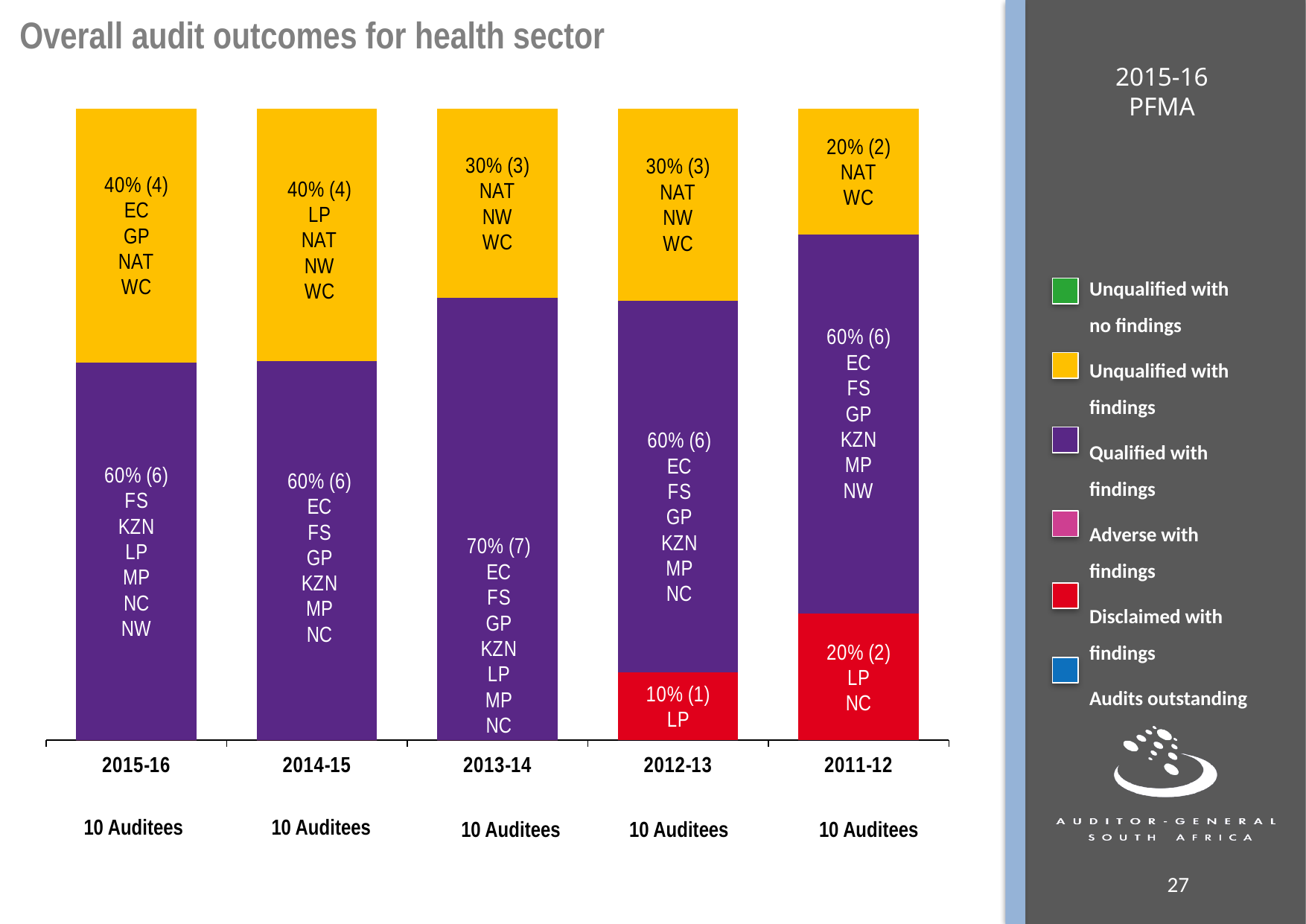
Which year has the highest share of 'Qualified with findings' auditees? 2013-14 How many entries does the legend list? 6 What percentage of auditees were 'Unqualified with findings' in 2015-16? 40% (4) How many auditees are there in each year shown? 10 Auditees How many years (categories) are shown on the x axis? 5 What kind of chart is shown on the slide? Stacked bar chart What is the title of the chart? Overall audit outcomes for health sector Which is larger: the 'Disclaimed with findings' share in 2012-13 or in 2011-12? 2011-12 Which year has the lowest share of 'Unqualified with findings' auditees? 2011-12 What is the difference in the 'Unqualified with findings' percentage between 2015-16 and 2011-12? 20% What percentage of auditees were 'Qualified with findings' in 2013-14? 70% (7) What percentage of auditees were 'Disclaimed with findings' in 2011-12? 20% (2)